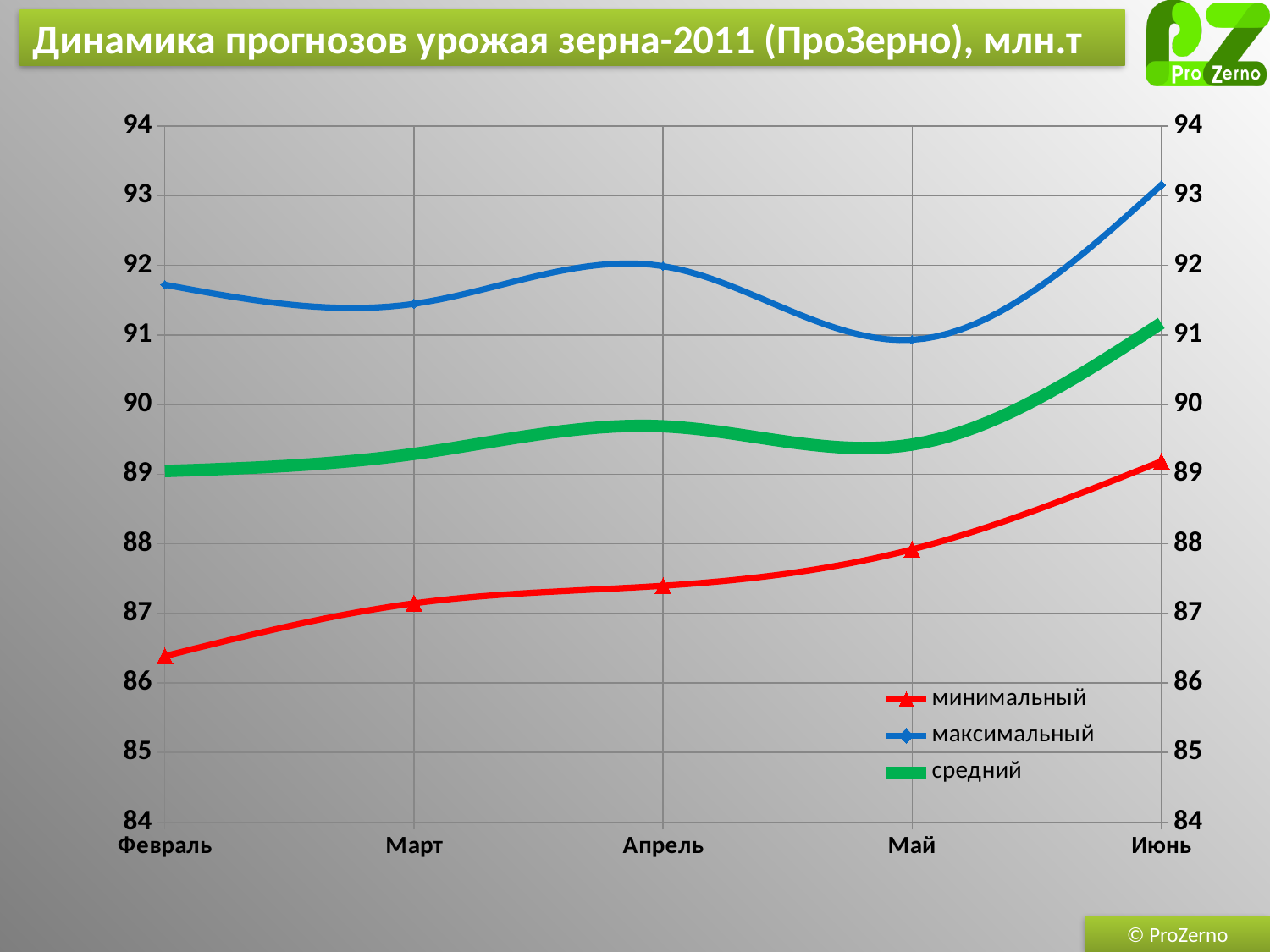
What kind of chart is shown on the slide? line chart Is the value for максимальный in Май greater or less than 92? less Is the value for максимальный in Июнь greater or less than 92? greater Which series is drawn in green? средний In which month is the максимальный series at its highest? Июнь Is the value for средний in Июнь greater or less than 90? greater How many months are shown on the x axis? 5 What is the title of the chart? Динамика прогнозов урожая зерна-2011 (ПроЗерно), млн.т Does the минимальный series rise or fall from Февраль to Июнь? rise In which month is the минимальный series at its lowest? Февраль How many series does the legend list? 3